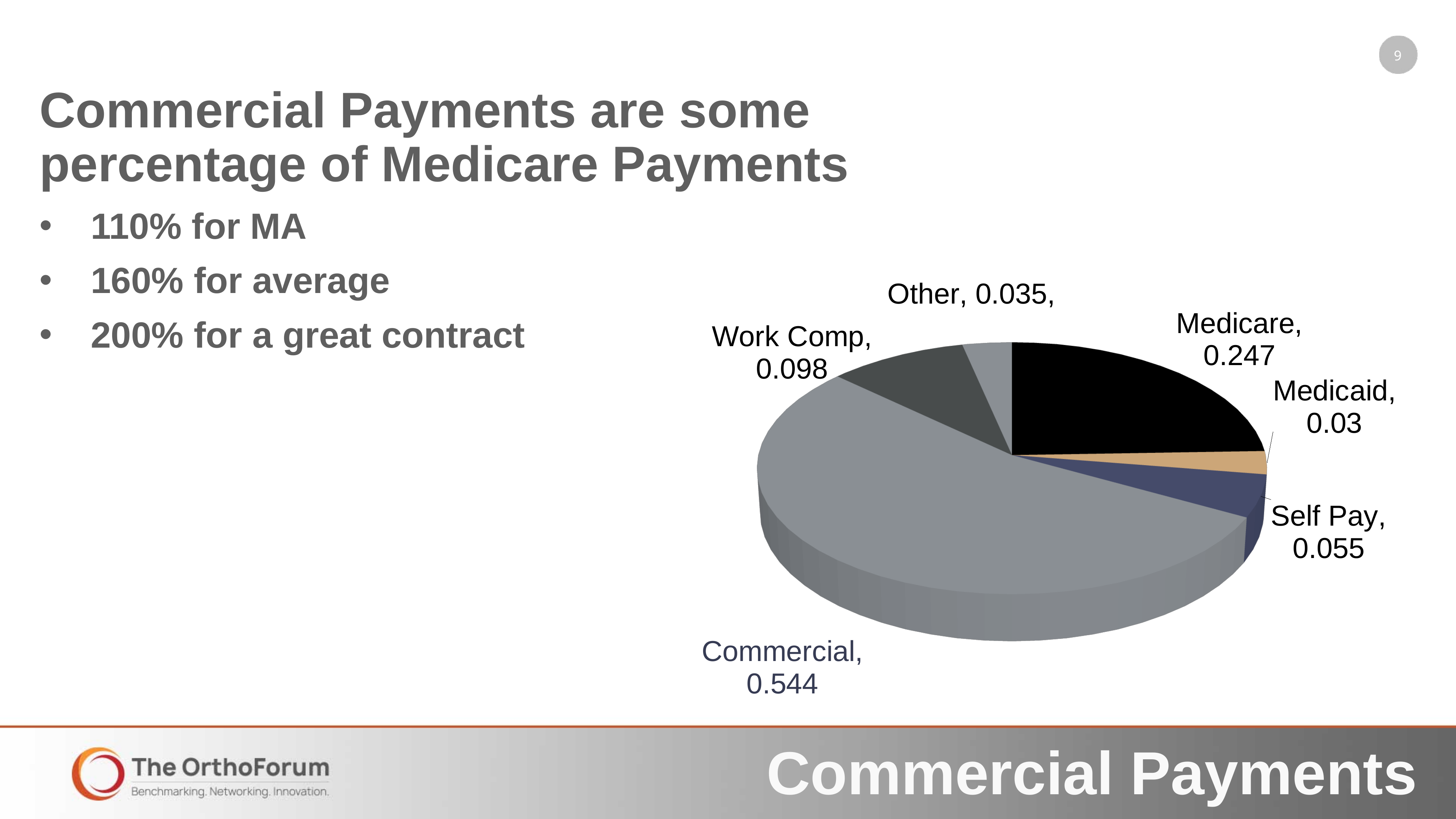
How many slices does the pie chart have? 6 Which category has the largest slice in the pie chart? Commercial Which category has the smallest slice in the pie chart? Medicaid What is the value for Work Comp in the pie chart? 0.098 What kind of chart is shown on the slide? Pie chart What is the value for Medicare in the pie chart? 0.247 What colour is the Medicare slice in the pie chart? Black What is the difference between the Commercial and Medicare values in the pie chart? 0.297 What is the value for Self Pay in the pie chart? 0.055 What is the value for Medicaid in the pie chart? 0.03 Which is larger in the pie chart, Work Comp or Self Pay? Work Comp What is the value for Commercial in the pie chart? 0.544